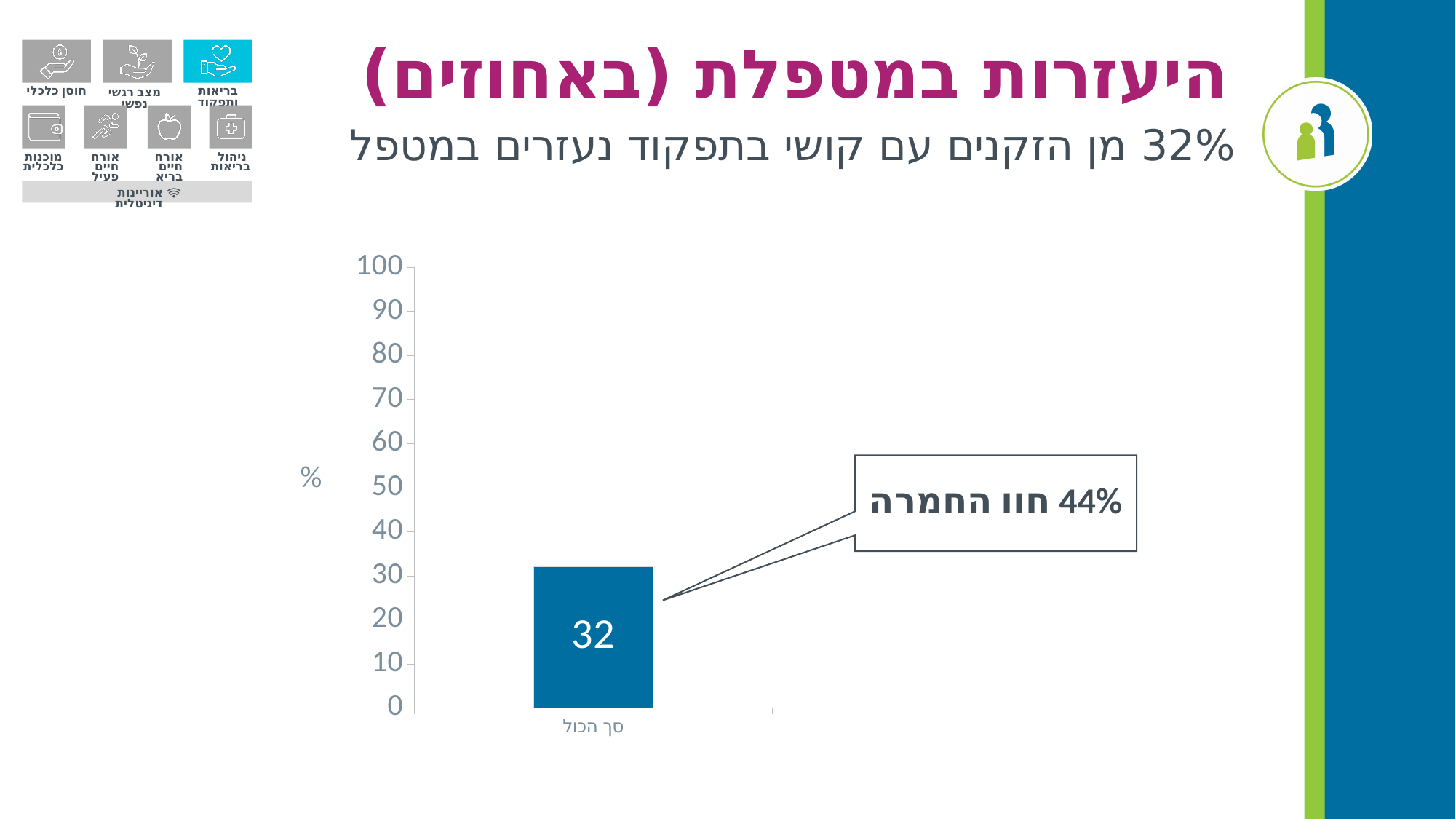
What unit label is shown on the vertical axis? % How many bars are plotted in the chart? 1 What is the value of the bar labeled "סך הכול"? 32 What percentage is stated in the callout box pointing to the bar? 44% What kind of chart is shown on the slide? bar chart Is the value for "סך הכול" greater or less than 30? greater What is the label of the single category on the x axis? סך הכול Is the value for "סך הכול" greater or less than 50? less What is the maximum value shown on the vertical axis? 100